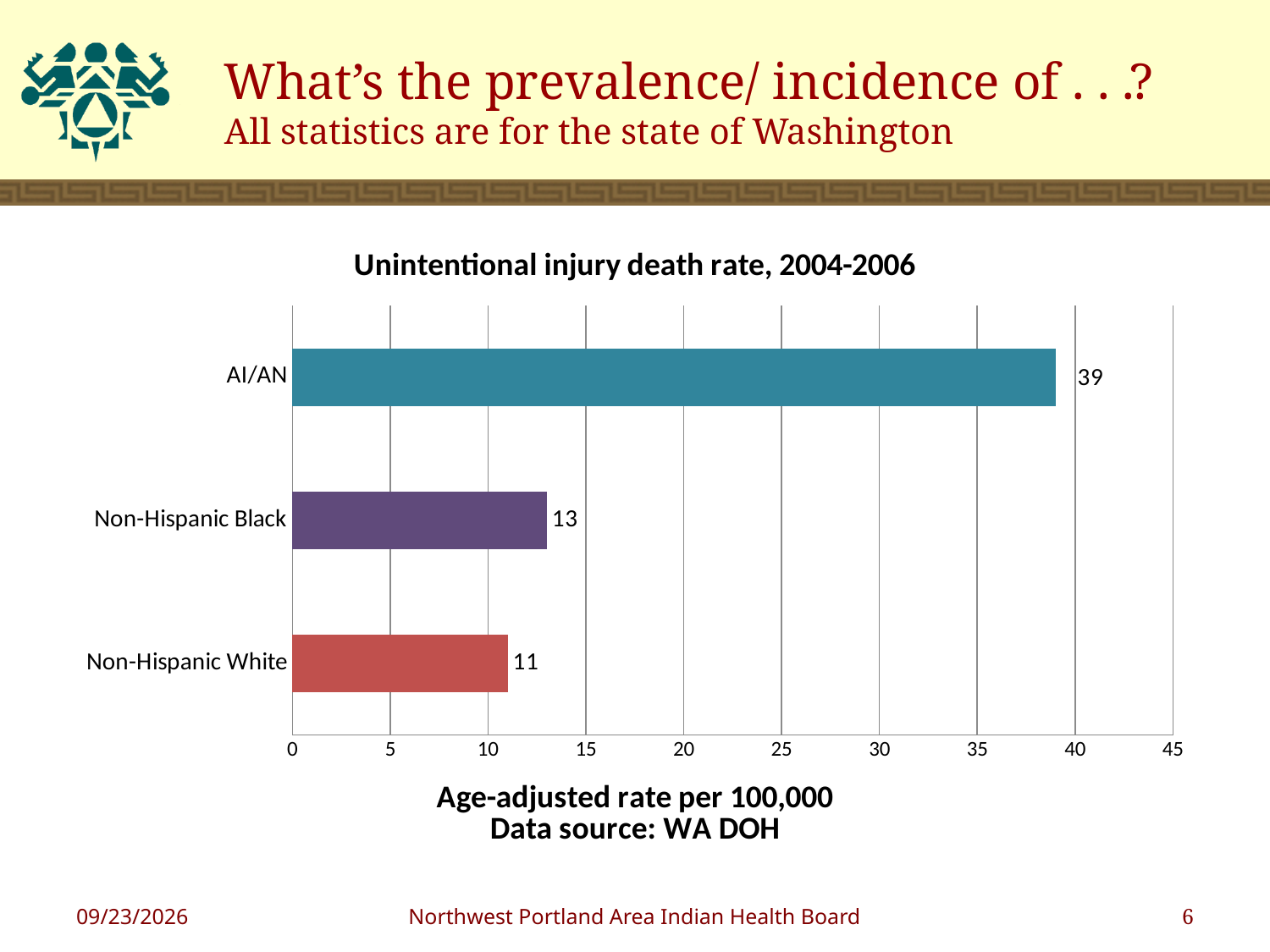
What is the difference between the AI/AN rate and the Non-Hispanic White rate? 28 What is the unintentional injury death rate for Non-Hispanic Black? 13 Which is larger, the rate for AI/AN or the rate for Non-Hispanic Black? AI/AN What is the unintentional injury death rate for Non-Hispanic White? 11 Which group has the highest unintentional injury death rate? AI/AN Is the value for AI/AN greater or less than 35? greater Which group has the lowest unintentional injury death rate? Non-Hispanic White What is the difference between the Non-Hispanic Black rate and the Non-Hispanic White rate? 2 How many groups are shown in the chart? 3 What kind of chart is shown on the slide? bar chart What is the unintentional injury death rate for AI/AN? 39 What is the title of the chart? Unintentional injury death rate, 2004-2006